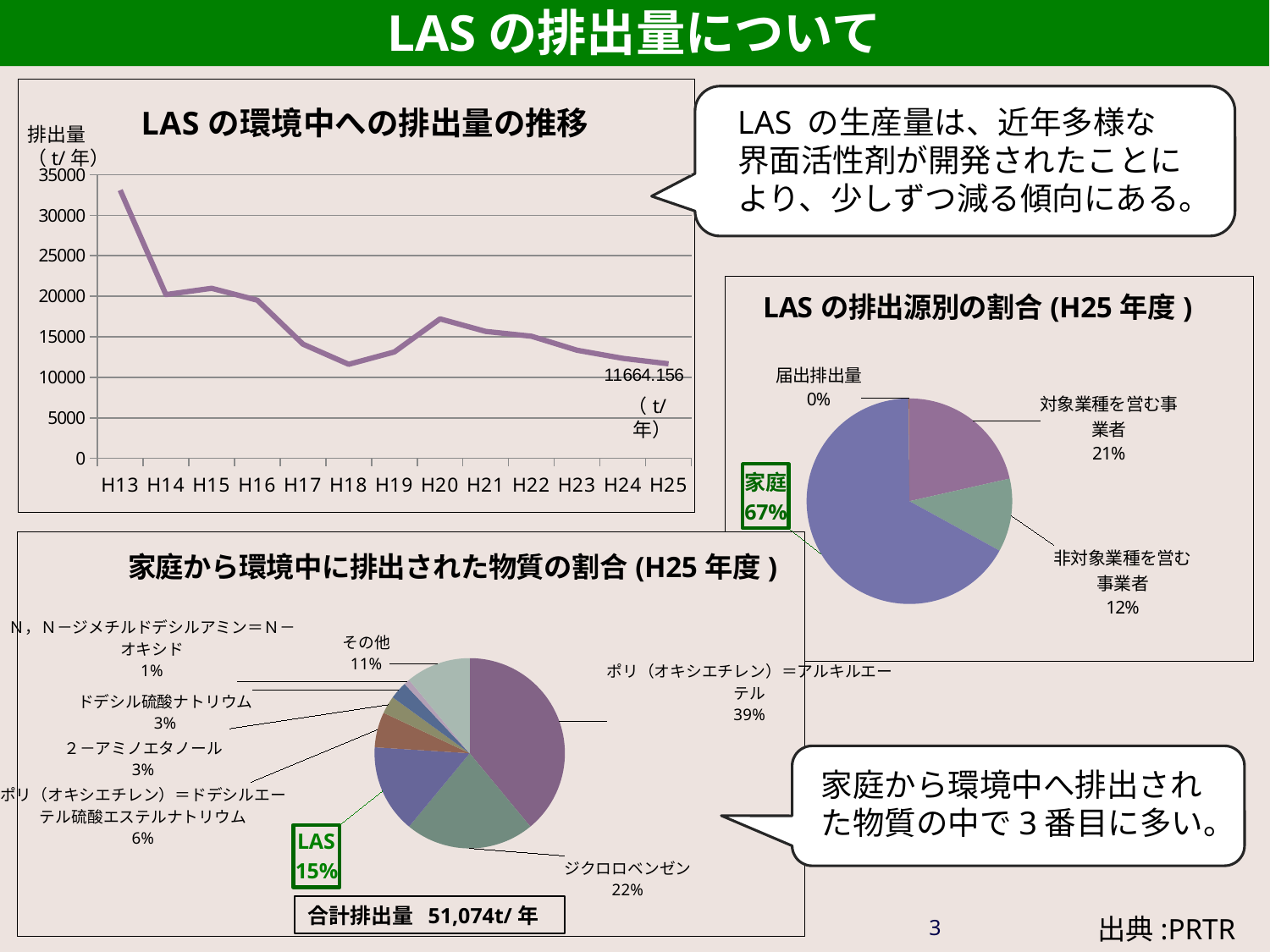
In the chart titled 'LASの環境中への排出量の推移', which year has the highest emission value? H13 In the chart titled 'LASの環境中への排出量の推移', how many years are plotted on the x axis? 13 In the chart titled 'LASの環境中への排出量の推移', what is the value printed for H25? 11664.156 In the pie chart titled '家庭から環境中に排出された物質の割合(H25年度)', what is the total emission amount (合計排出量) shown? 51,074t/年 In the chart titled 'LASの環境中への排出量の推移', is the value for H13 greater or less than 30000? greater In the pie chart titled 'LASの排出源別の割合(H25年度)', what share is 家庭? 67% What kind of chart is 'LASの環境中への排出量の推移'? line chart In the pie chart titled '家庭から環境中に排出された物質の割合(H25年度)', what share is LAS? 15% In the pie chart titled '家庭から環境中に排出された物質の割合(H25年度)', which substance has the largest share? ポリ（オキシエチレン）＝アルキルエーテル In the chart titled 'LASの環境中への排出量の推移', is the value for H18 greater or less than 15000? less In the pie chart titled 'LASの排出源別の割合(H25年度)', what is the difference between the shares of 対象業種を営む事業者 and 非対象業種を営む事業者? 9% In the chart titled 'LASの環境中への排出量の推移', do the values generally rise or fall from H13 to H25? fall